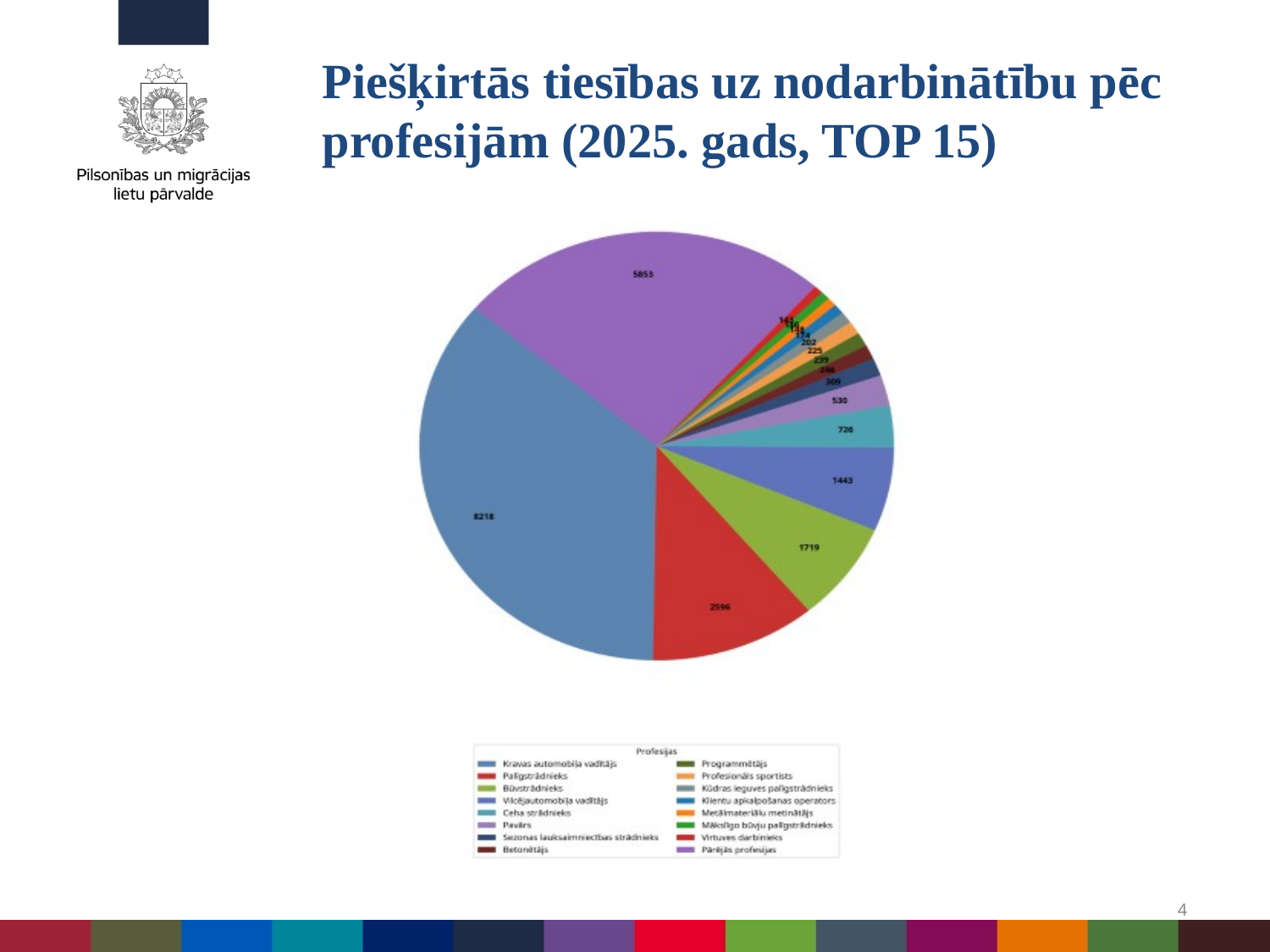
What value is shown for Ceha strādnieks? 726 What kind of chart is shown on the slide? pie chart What value is shown for Vilcējautomobiļa vadītājs? 1443 What is the title of the legend? Profesijas What is the difference between the values for Kravas automobiļa vadītājs and Palīgstrādnieks? 5622 Which is larger, the value for Pavārs or the value for Ceha strādnieks? Ceha strādnieks What value is shown for Palīgstrādnieks? 2596 What value is shown for Būvstrādnieks? 1719 Which profession has the largest slice of the pie? Kravas automobiļa vadītājs What value is shown for Kravas automobiļa vadītājs? 8218 What value is shown for Pārējās profesijas? 5853 How many entries does the legend list? 16